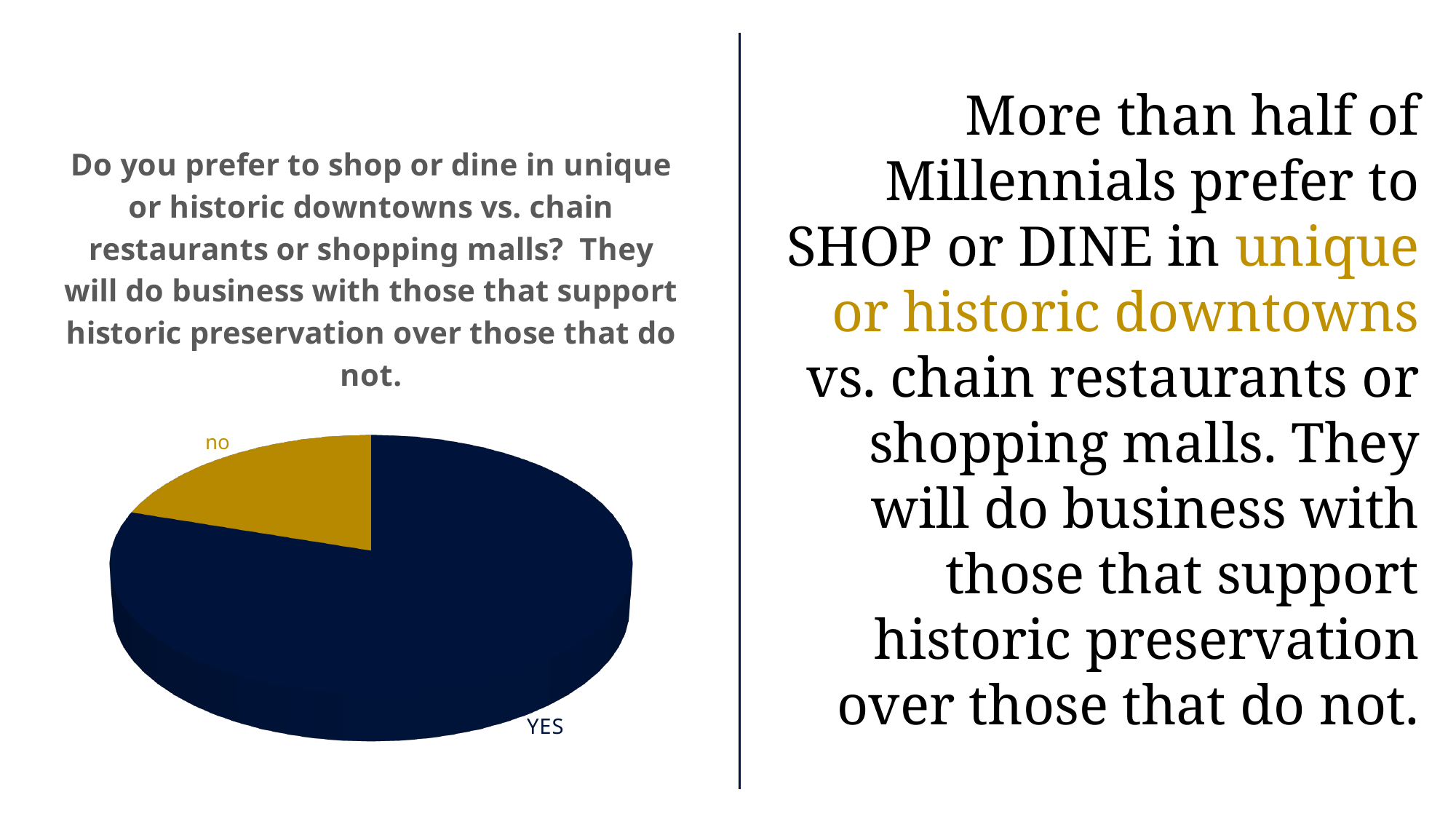
How many slices does the pie chart have? 2 What kind of chart is shown on the slide? Pie chart What colour is the YES slice of the pie chart? Dark navy blue Which slice of the pie chart is the largest? YES What colour is the no slice of the pie chart? Gold Which slice of the pie chart is the smallest? no Does the YES slice take up more or less than half of the pie chart? More Which slice is larger in the pie chart, YES or no? YES